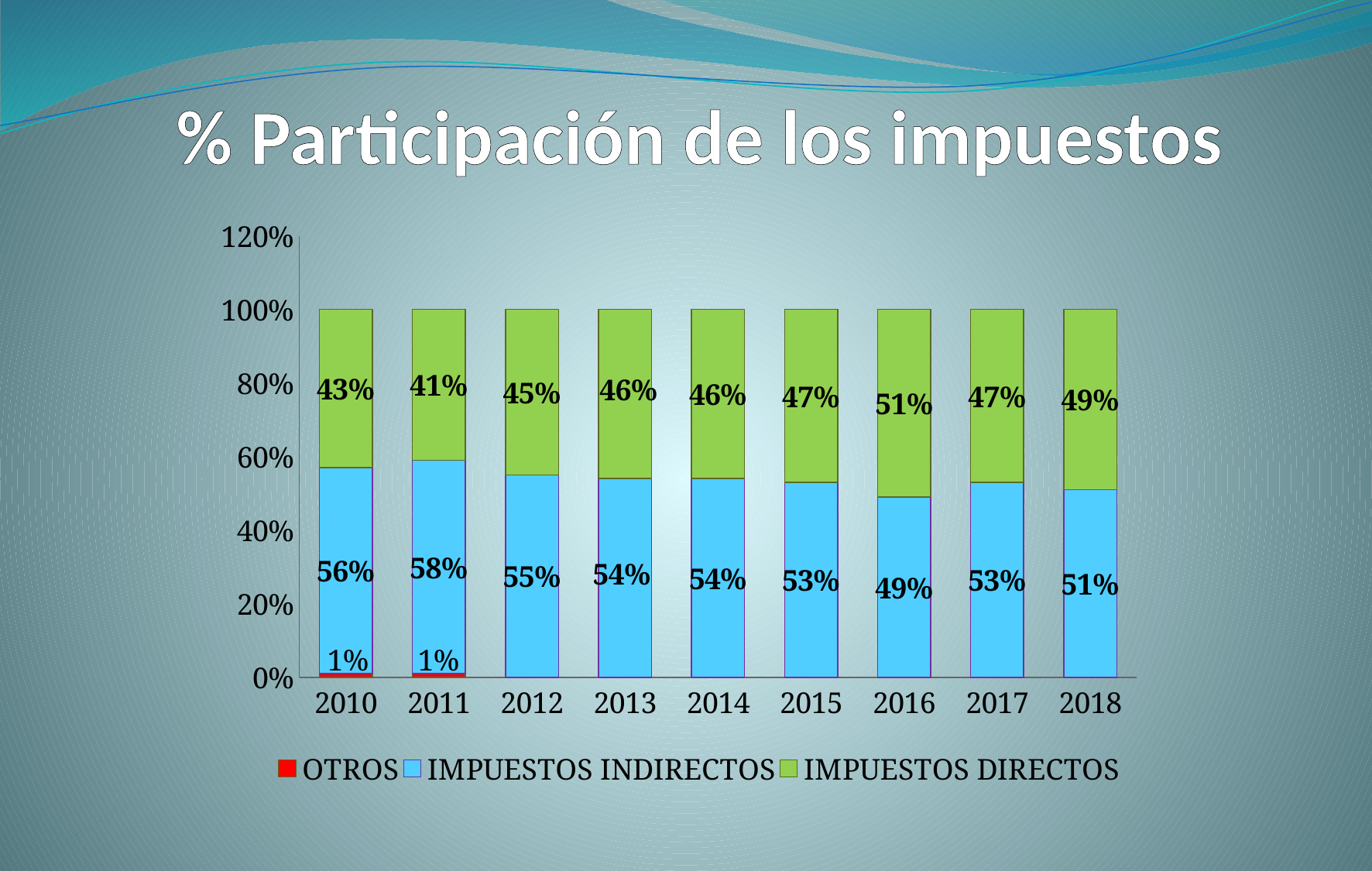
What kind of chart is shown? Stacked bar chart In which year is IMPUESTOS INDIRECTOS highest? 2011 How many years are shown on the x axis? 9 How many series does the legend list? 3 What is the value for OTROS in 2010? 1% In which year is IMPUESTOS DIRECTOS lowest? 2011 Which is larger in 2016, IMPUESTOS INDIRECTOS or IMPUESTOS DIRECTOS? IMPUESTOS DIRECTOS What is the value for IMPUESTOS INDIRECTOS in 2011? 58% What is the difference between IMPUESTOS INDIRECTOS and IMPUESTOS DIRECTOS in 2010? 13% What is the title of the chart? % Participación de los impuestos Does the value for IMPUESTOS INDIRECTOS rise or fall from 2011 to 2016? Fall What is the value for IMPUESTOS DIRECTOS in 2016? 51%